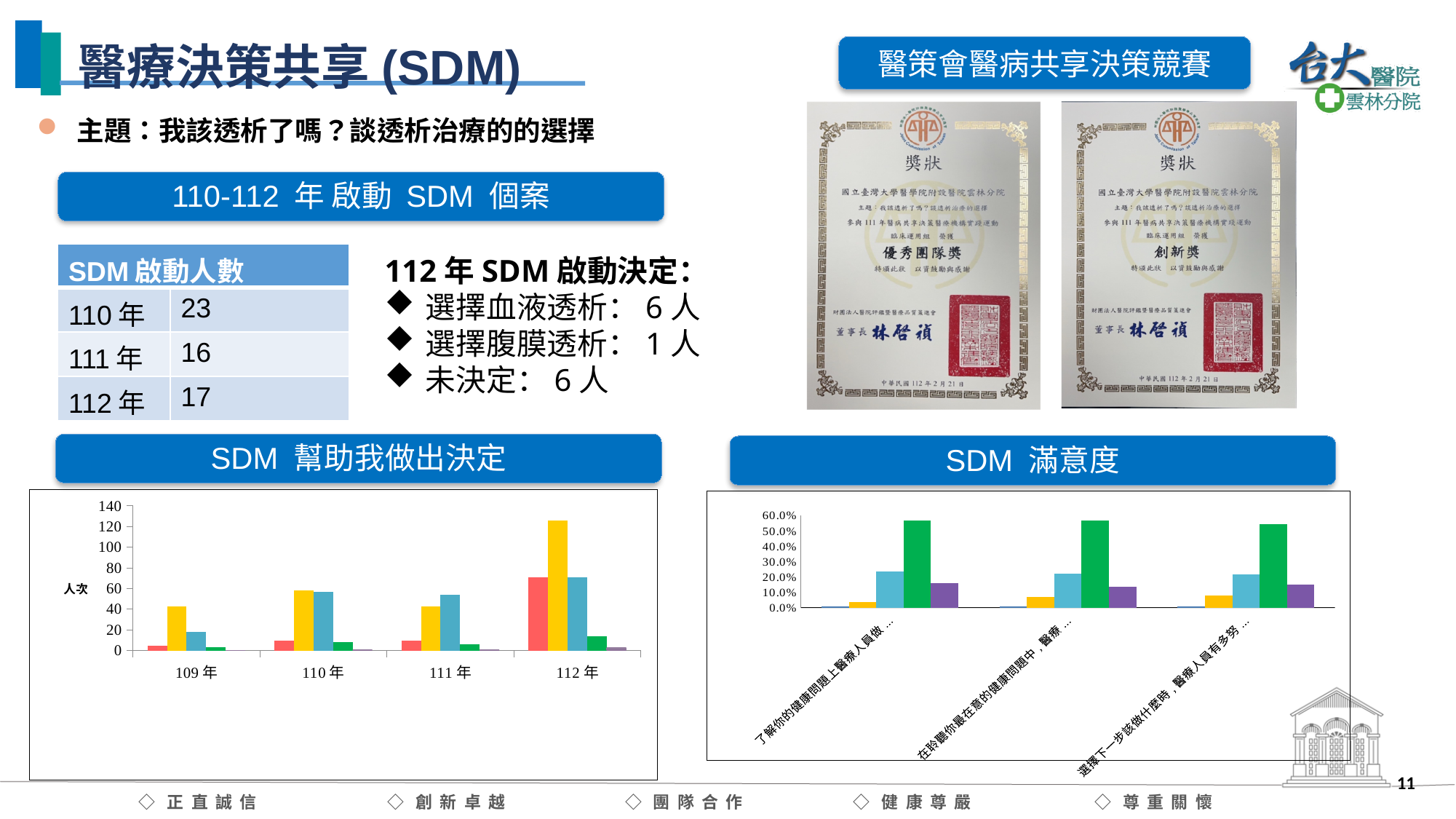
In the "SDM 幫助我做出決定" chart, is the yellow bar larger for 110 年 or for 111 年? 110 年 In the "SDM 幫助我做出決定" chart, is the red bar for 112 年 greater or less than 60? greater In the "SDM 滿意度" chart, is the green bar for the first category greater or less than 50.0%? greater In the "SDM 幫助我做出決定" chart, which year has the tallest bar? 112 年 What is the y-axis label of the "SDM 幫助我做出決定" chart? 人次 How many year categories are shown on the x axis of the "SDM 幫助我做出決定" chart? 4 How many question categories are shown on the x axis of the "SDM 滿意度" chart? 3 In the "SDM 幫助我做出決定" chart, is the yellow bar for 112 年 greater or less than 100? greater What kind of chart is the "SDM 滿意度" chart? bar chart What kind of chart is the "SDM 幫助我做出決定" chart? bar chart